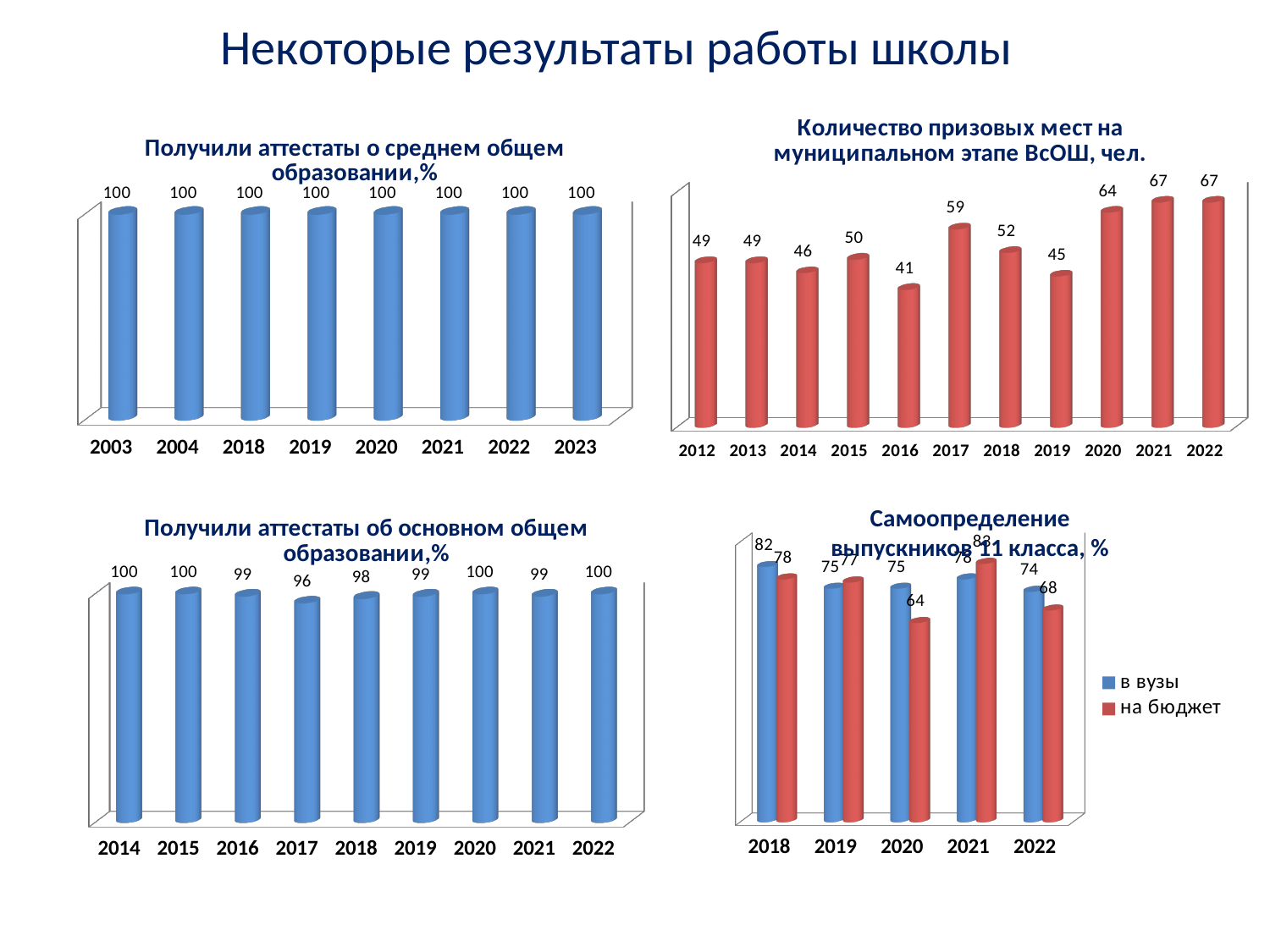
In the chart 'Самоопределение выпускников 11 класса, %', what is the value of 'на бюджет' for 2020? 64 In the chart 'Получили аттестаты о среднем общем образовании,%', what is the value for 2021? 100 In the chart 'Получили аттестаты об основном общем образовании,%', which year has the lowest value? 2017 In the chart 'Количество призовых мест на муниципальном этапе ВсОШ, чел.', which year has the lowest value? 2016 How many years are shown in the chart 'Количество призовых мест на муниципальном этапе ВсОШ, чел.'? 11 In the chart 'Количество призовых мест на муниципальном этапе ВсОШ, чел.', what is the difference between the values for 2020 and 2019? 19 How many years are shown in the chart 'Получили аттестаты об основном общем образовании,%'? 9 In the chart 'Количество призовых мест на муниципальном этапе ВсОШ, чел.', what is the value for 2017? 59 How many series does the legend list in the chart 'Самоопределение выпускников 11 класса, %'? 2 In the chart 'Самоопределение выпускников 11 класса, %', which is larger for 2021: 'в вузы' or 'на бюджет'? на бюджет In the chart 'Получили аттестаты об основном общем образовании,%', what is the value for 2018? 98 What type of chart is 'Количество призовых мест на муниципальном этапе ВсОШ, чел.'? bar chart